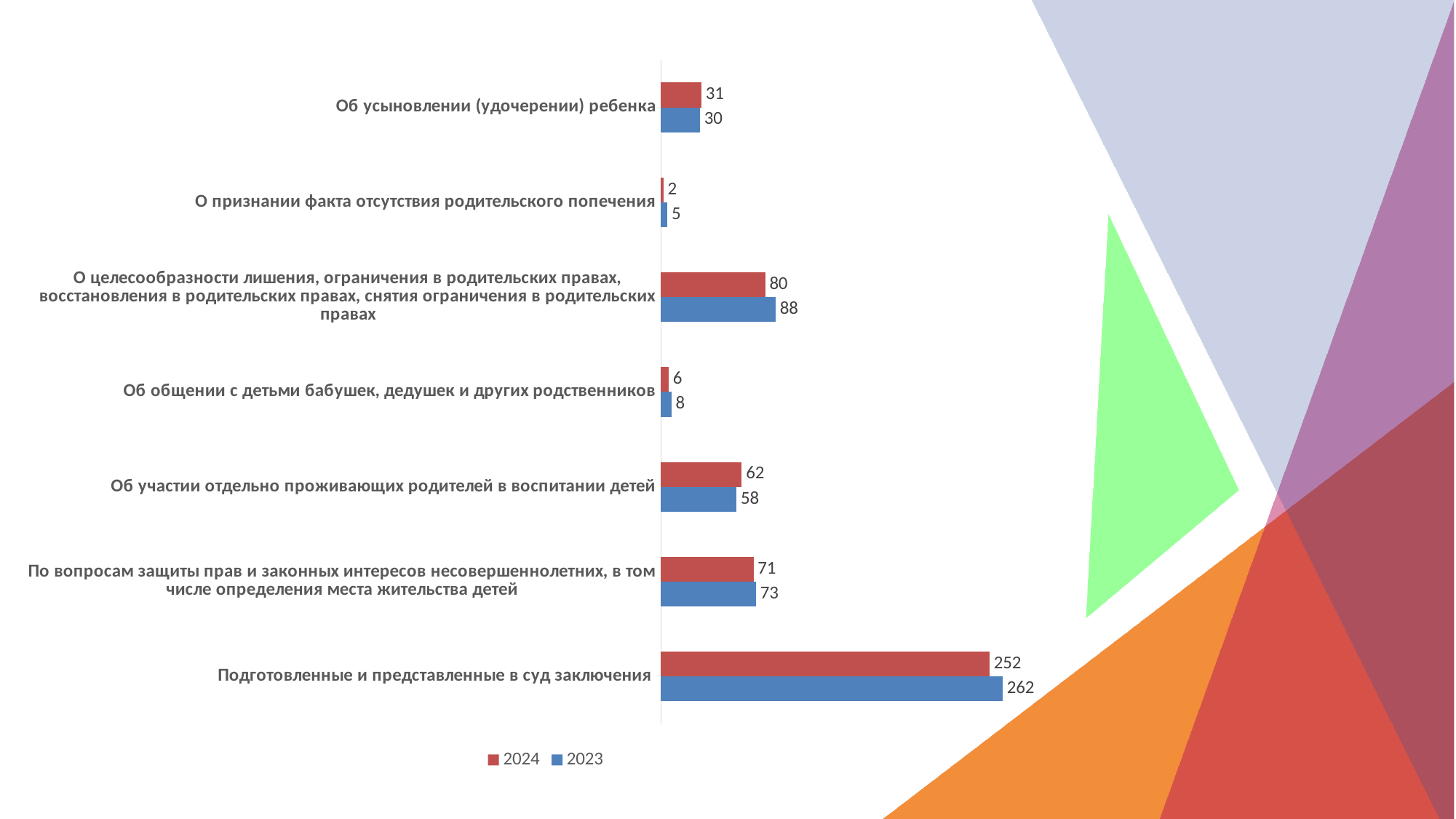
How many series does the legend list? 2 Which category has the highest 2023 value? Подготовленные и представленные в суд заключения How many categories are shown on the chart? 7 What is the difference between the 2024 and 2023 values for "Об участии отдельно проживающих родителей в воспитании детей"? 4 What is the 2023 value for "Об усыновлении (удочерении) ребенка"? 30 What is the 2024 value for "Подготовленные и представленные в суд заключения"? 252 What is the difference between the 2023 and 2024 values for "Подготовленные и представленные в суд заключения"? 10 Which category has the lowest 2024 value? О признании факта отсутствия родительского попечения For "По вопросам защиты прав и законных интересов несовершеннолетних, в том числе определения места жительства детей", which year has the larger value, 2024 or 2023? 2023 Which colour represents the 2024 series in the legend? Red What is the 2023 value for "О целесообразности лишения, ограничения в родительских правах, восстановления в родительских правах, снятия ограничения в родительских правах"? 88 What kind of chart is shown on the slide? Bar chart